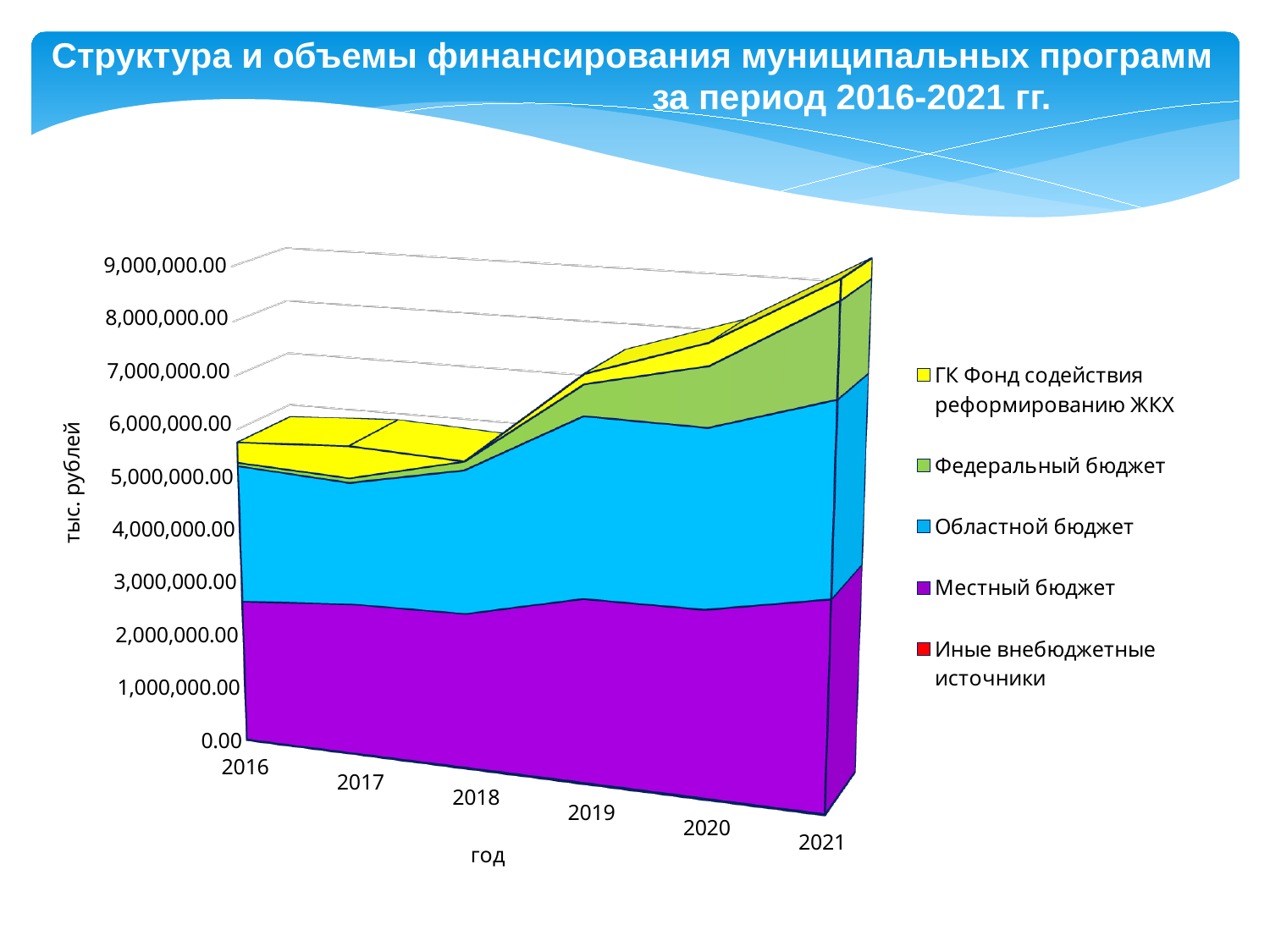
Is the total funding in 2017 greater or less than 7,000,000.00? less What is the title of the chart? Структура и объемы финансирования муниципальных программ за период 2016-2021 гг. Which series is shown in blue? Областной бюджет Does the total funding rise or fall from 2016 to 2021 overall? rise How many series does the legend list? 5 What kind of chart is shown on the slide? Area chart Is the total funding in 2016 greater or less than 5,000,000.00? greater Is the total funding in 2021 greater or less than 8,000,000.00? greater Which year has the highest total funding? 2021 What is the label of the vertical axis? тыс. рублей How many years are plotted along the x axis? 6